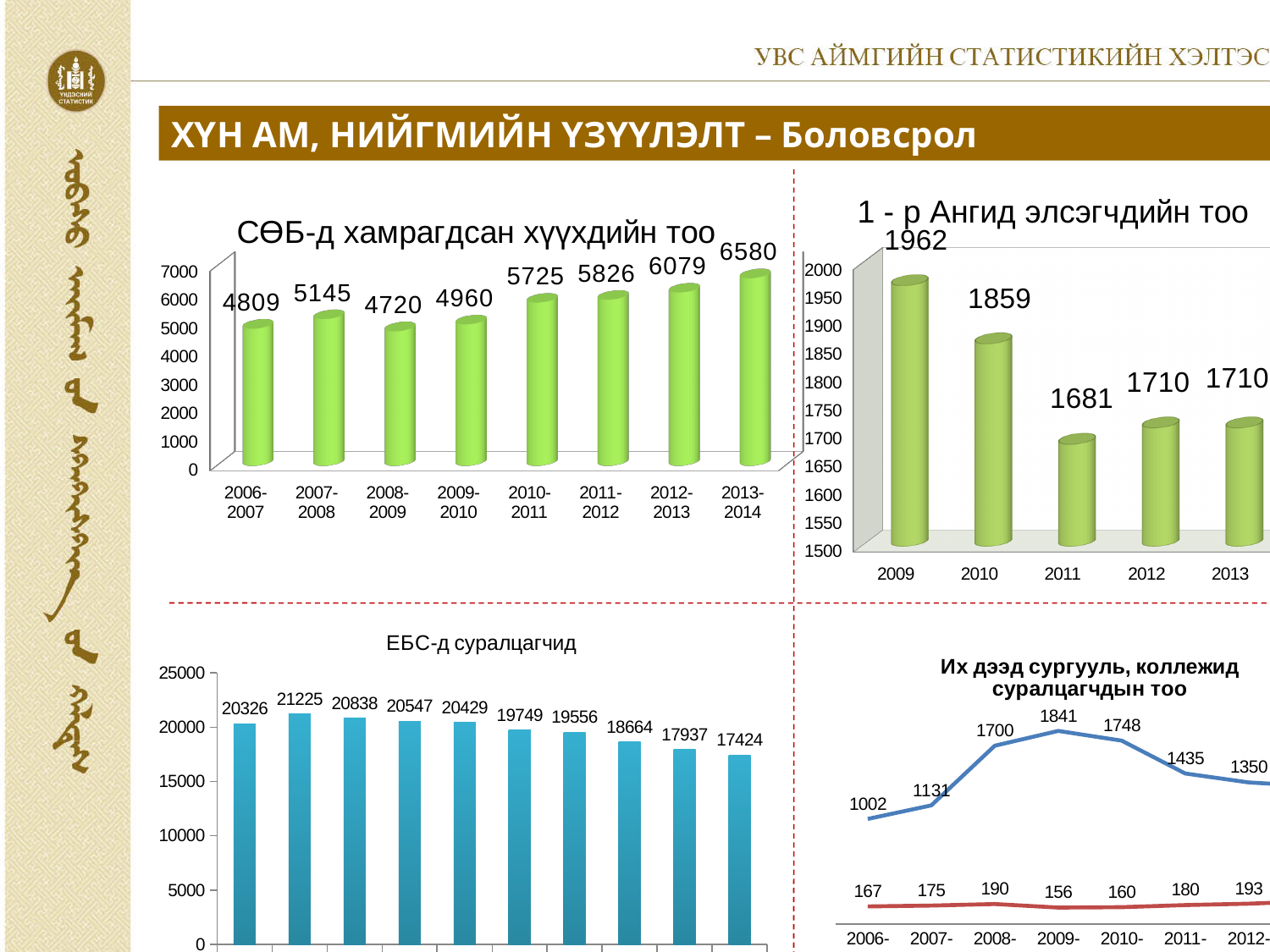
In the chart titled 'ЕБС-д суралцагчид', what is the highest value shown? 21225 In the chart titled '1 - р Ангид элсэгчдийн тоо', which is larger, the value for 2009 or the value for 2013? 2009 In the chart titled 'СӨБ-д хамрагдсан хүүхдийн тоо', what is the value for 2010-2011? 5725 In the chart titled '1 - р Ангид элсэгчдийн тоо', what is the value for 2010? 1859 In the chart titled '1 - р Ангид элсэгчдийн тоо', which year has the lowest value? 2011 In the chart titled 'СӨБ-д хамрагдсан хүүхдийн тоо', which category has the lowest value? 2008-2009 How many bars are shown in the chart titled 'ЕБС-д суралцагчид'? 10 What kind of chart is the chart titled 'ЕБС-д суралцагчид'? bar chart In the chart titled 'Их дээд сургууль, коллежид суралцагчдын тоо', what is the highest value on the blue line? 1841 How many categories are shown in the chart titled 'СӨБ-д хамрагдсан хүүхдийн тоо'? 8 In the chart titled 'СӨБ-д хамрагдсан хүүхдийн тоо', what is the difference between the values for 2013-2014 and 2012-2013? 501 In the chart titled 'СӨБ-д хамрагдсан хүүхдийн тоо', which category has the highest value? 2013-2014